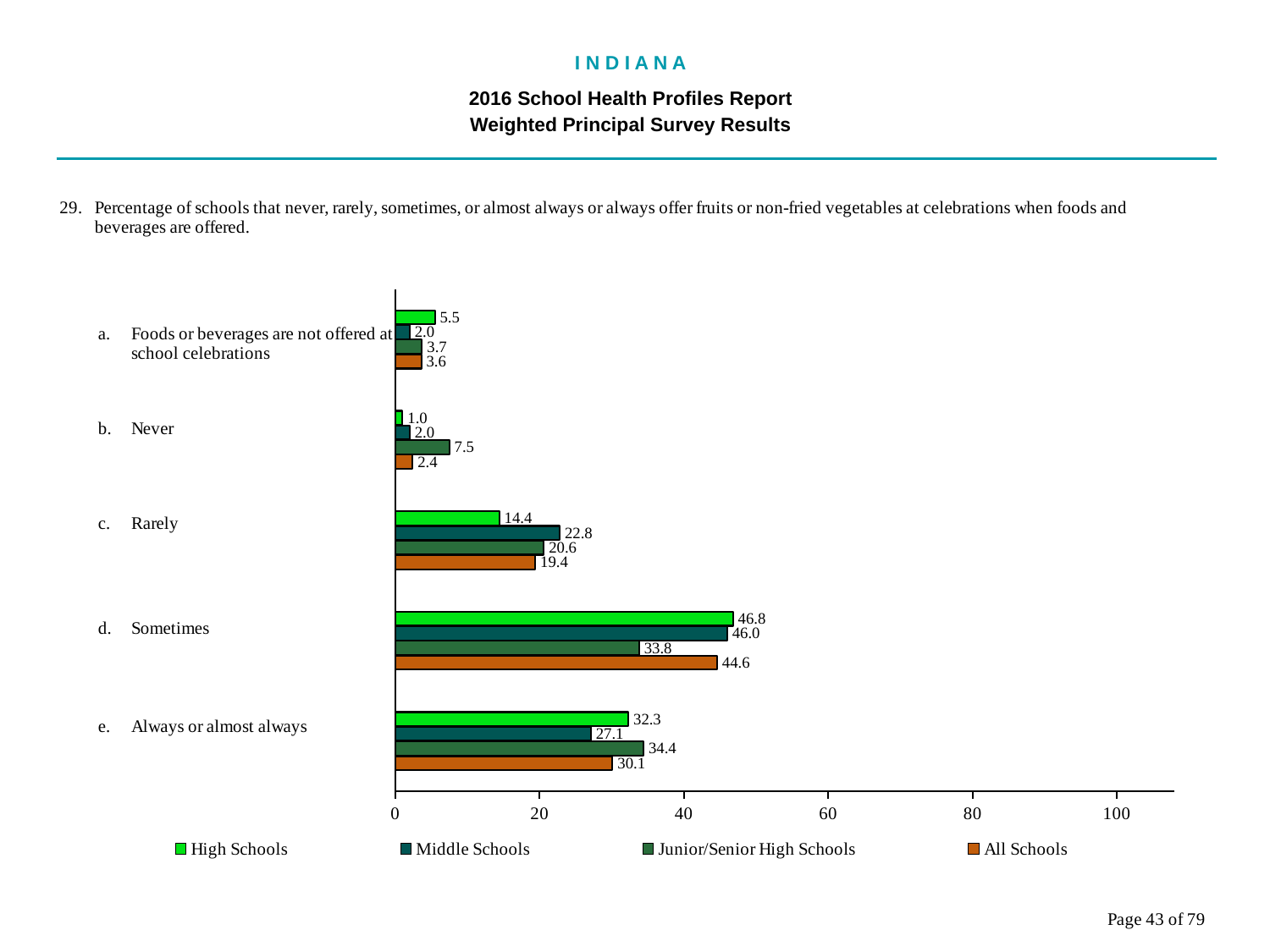
In the "Sometimes" category, which is larger: the value for Middle Schools or for Junior/Senior High Schools? Middle Schools Which category has the lowest value for High Schools? Never What is the difference between the High Schools and Middle Schools values in the "Always or almost always" category? 5.2 Which category has the highest value for All Schools? Sometimes How many series does the legend list? 4 What is the value for Junior/Senior High Schools in the "Never" category? 7.5 Is the value for All Schools in the "Sometimes" category greater or less than 40? greater What kind of chart is shown on the slide? Bar chart How many categories are shown on the chart? 5 What is the value for Middle Schools in the "Rarely" category? 22.8 What is the value for All Schools in the "Always or almost always" category? 30.1 What is the value for High Schools in the "Sometimes" category? 46.8